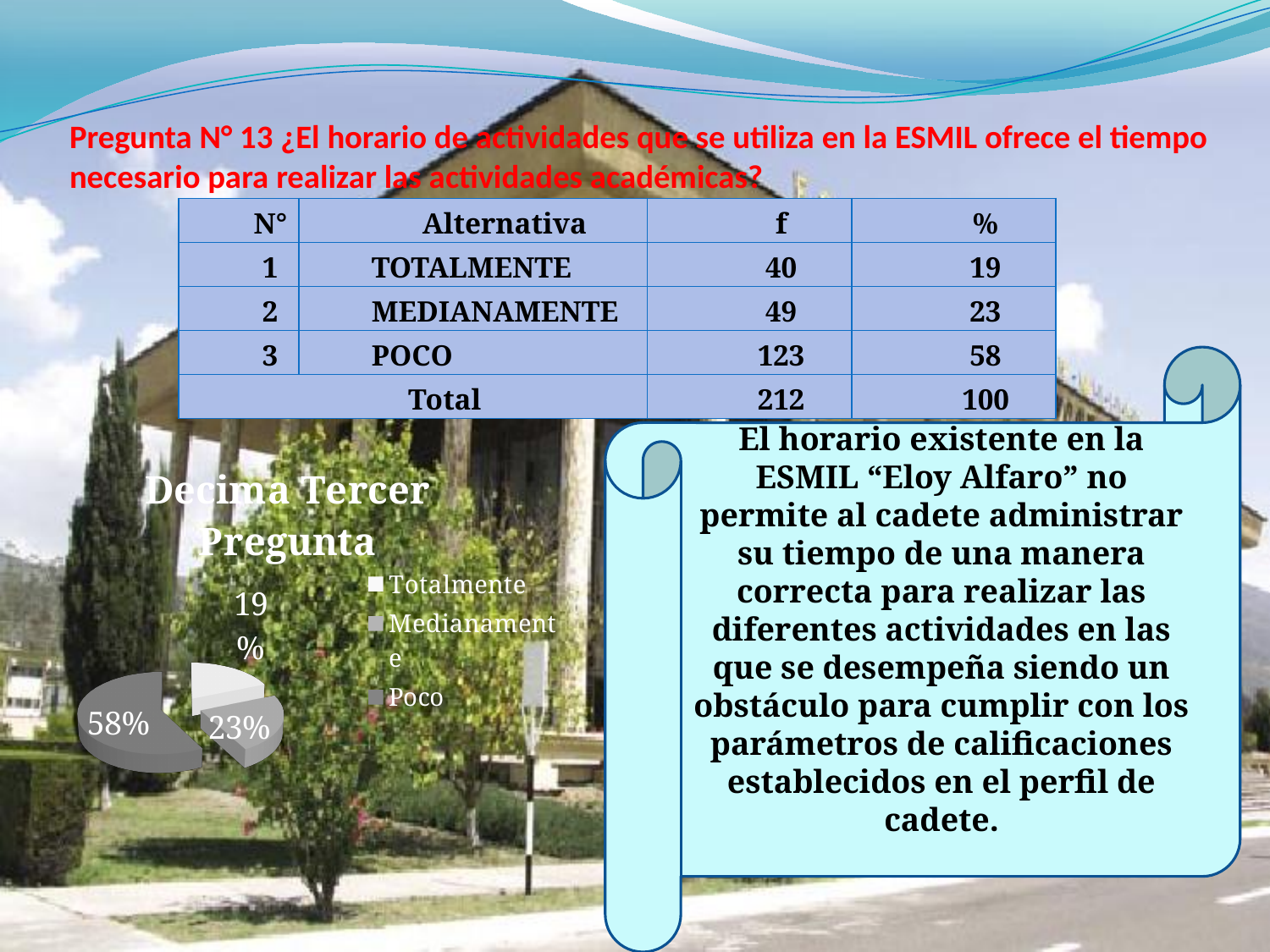
What share of the pie does Medianamente represent? 23% How many entries does the chart legend list? 3 What is the combined share of the Totalmente and Medianamente slices? 42% Which category has the smallest slice of the pie? Totalmente What share of the pie does Poco represent? 58% How many slices does the pie chart have? 3 Which category has the largest slice of the pie? Poco What kind of chart is shown on the slide? pie chart What share of the pie does Totalmente represent? 19% Which slice is larger, Medianamente or Totalmente? Medianamente What is the title of the chart? Decima Tercer Pregunta What is the difference in percentage points between the Poco slice and the Medianamente slice? 35